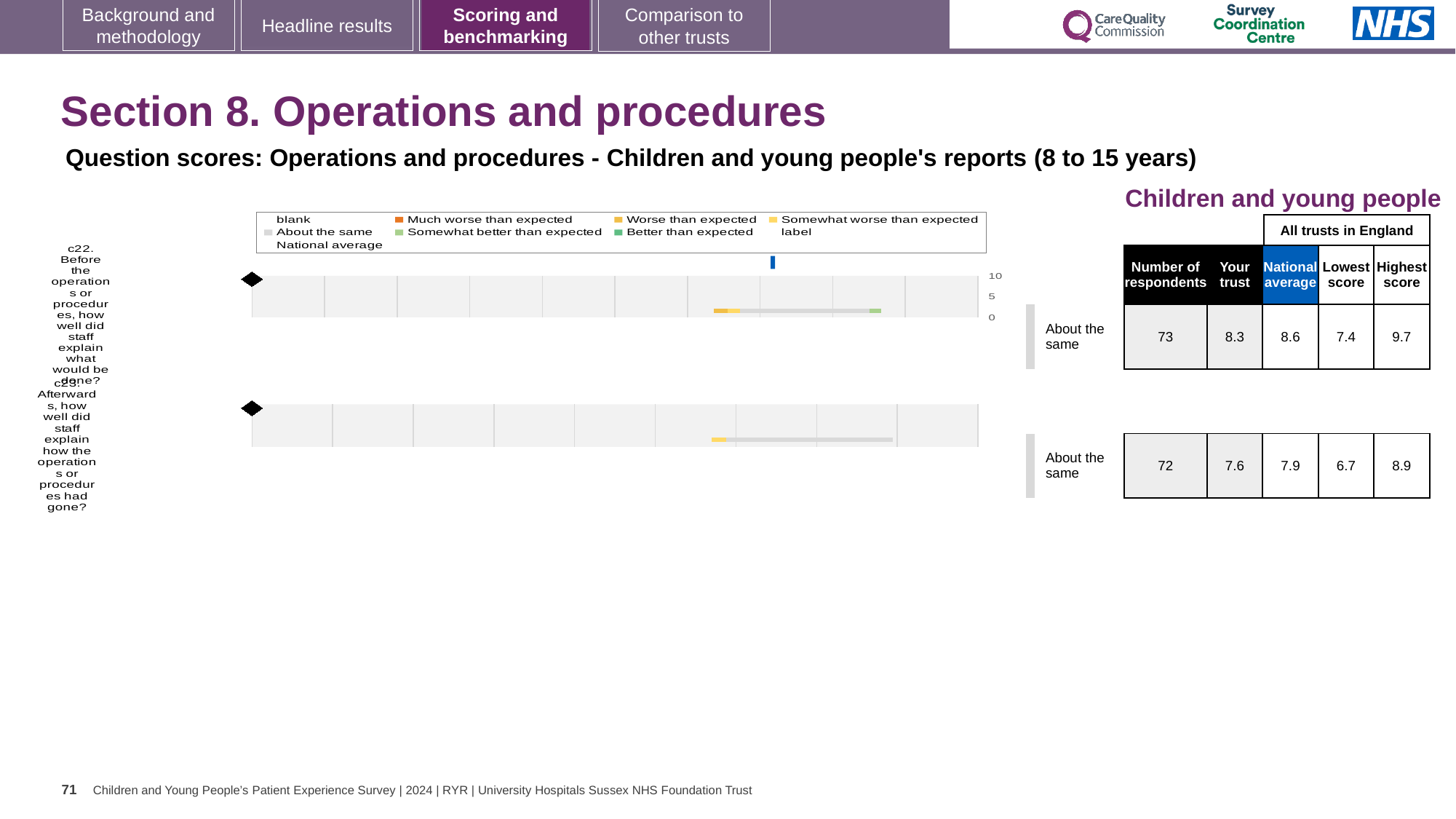
What is the 'Your trust' score for c23 (Afterwards, how well did staff explain how the operations or procedures had gone?)? 7.6 How many entries does the chart legend list? 9 What is the National average for c22? 8.6 What benchmarking category is shown for both c22 and c23? About the same What is the difference between the National average and the 'Your trust' score for c23? 0.3 Which question has the higher 'Your trust' score, c22 or c23? c22 How many respondents answered c22? 73 What is the Highest score across all trusts in England for c23? 8.9 What kind of chart is used for the c22 and c23 question rows on the slide? bar chart How many question rows (c22 and c23) are plotted on the slide? 2 What is the difference between the Highest score and the Lowest score for c22? 2.3 What is the 'Your trust' score for c22 (Before the operations or procedures, how well did staff explain what would be done?)? 8.3